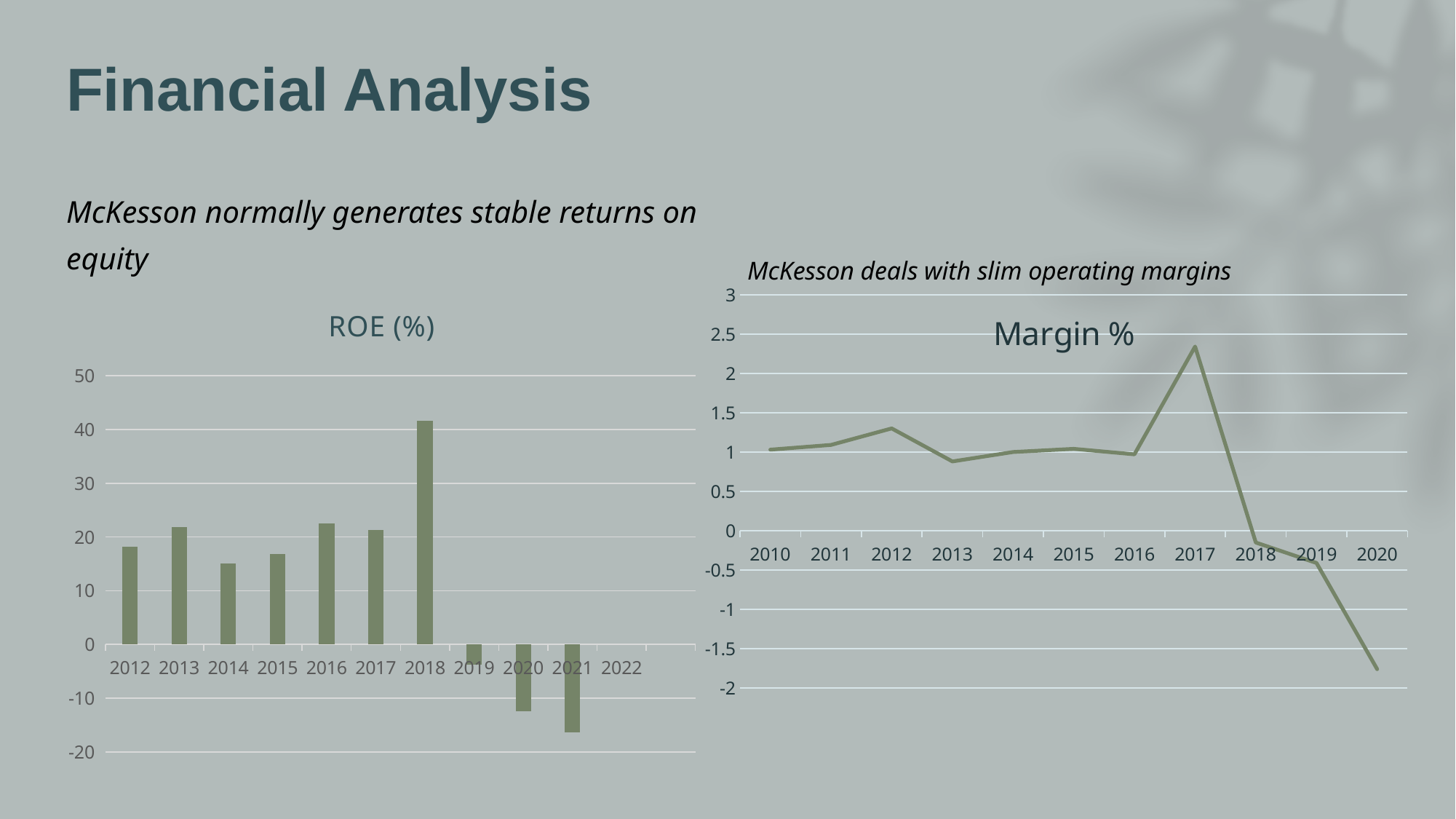
On the Margin % chart, is the value for 2017 greater or less than 2? greater On the ROE (%) chart, which year has the larger ROE, 2013 or 2014? 2013 On the Margin % chart, does the margin rise or fall from 2017 to 2020? Fall On the Margin % chart, how many years are plotted on the x axis? 11 On the ROE (%) chart, how many years show a negative ROE? 3 On the ROE (%) chart, is the value for 2018 greater or less than 40? greater On the Margin % chart, which year has the highest margin? 2017 On the Margin % chart, which year has the lowest margin? 2020 On the ROE (%) chart, is the value for 2020 greater or less than -10? less What kind of chart is the ROE (%) chart? Bar chart On the ROE (%) chart, which year has the lowest ROE? 2021 On the ROE (%) chart, which year has the highest ROE? 2018